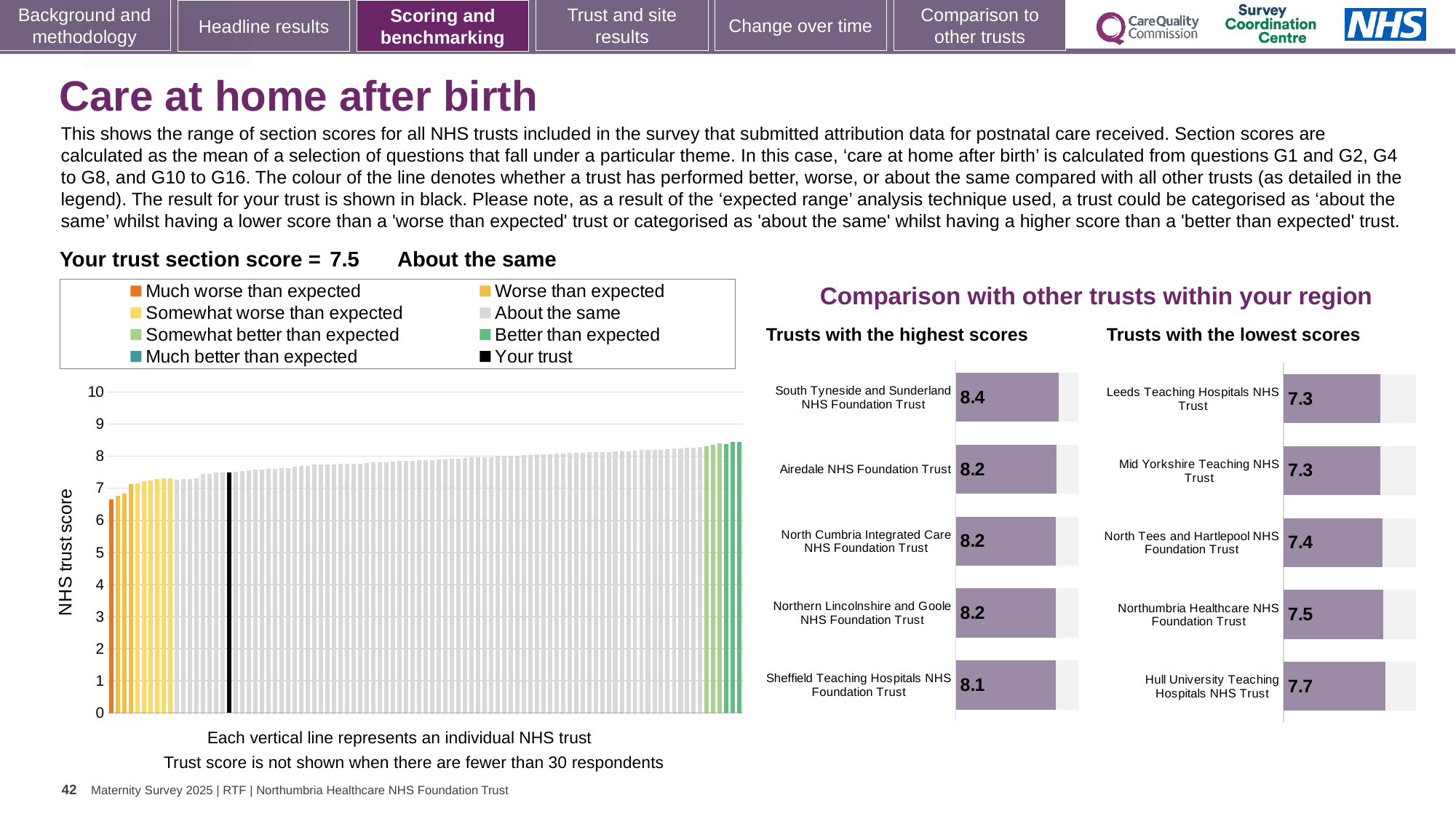
In the 'Trusts with the lowest scores' chart, which trust has the highest score? Hull University Teaching Hospitals NHS Trust Which has the larger score: Airedale NHS Foundation Trust in the 'highest scores' chart or Northumbria Healthcare NHS Foundation Trust in the 'lowest scores' chart? Airedale NHS Foundation Trust In the large 'NHS trust score' chart on the left, is the tallest bar greater or less than 9? less In the 'Trusts with the highest scores' chart, which trust has the highest score? South Tyneside and Sunderland NHS Foundation Trust In the 'Trusts with the highest scores' chart, what is the difference between the scores of South Tyneside and Sunderland NHS Foundation Trust and Sheffield Teaching Hospitals NHS Foundation Trust? 0.3 In the 'Trusts with the lowest scores' chart, what is the difference between the scores of Hull University Teaching Hospitals NHS Trust and Leeds Teaching Hospitals NHS Trust? 0.4 How many entries does the legend above the large 'NHS trust score' chart list? 8 In the 'Trusts with the highest scores' chart, what is the score for South Tyneside and Sunderland NHS Foundation Trust? 8.4 In the 'Trusts with the lowest scores' chart, what is the score for Hull University Teaching Hospitals NHS Trust? 7.7 In the large 'NHS trust score' chart on the left, do the bar values rise or fall from left to right? Rise What kind of chart is the large 'NHS trust score' chart on the left of the slide? Bar chart How many trusts are shown in the 'Trusts with the highest scores' chart? 5